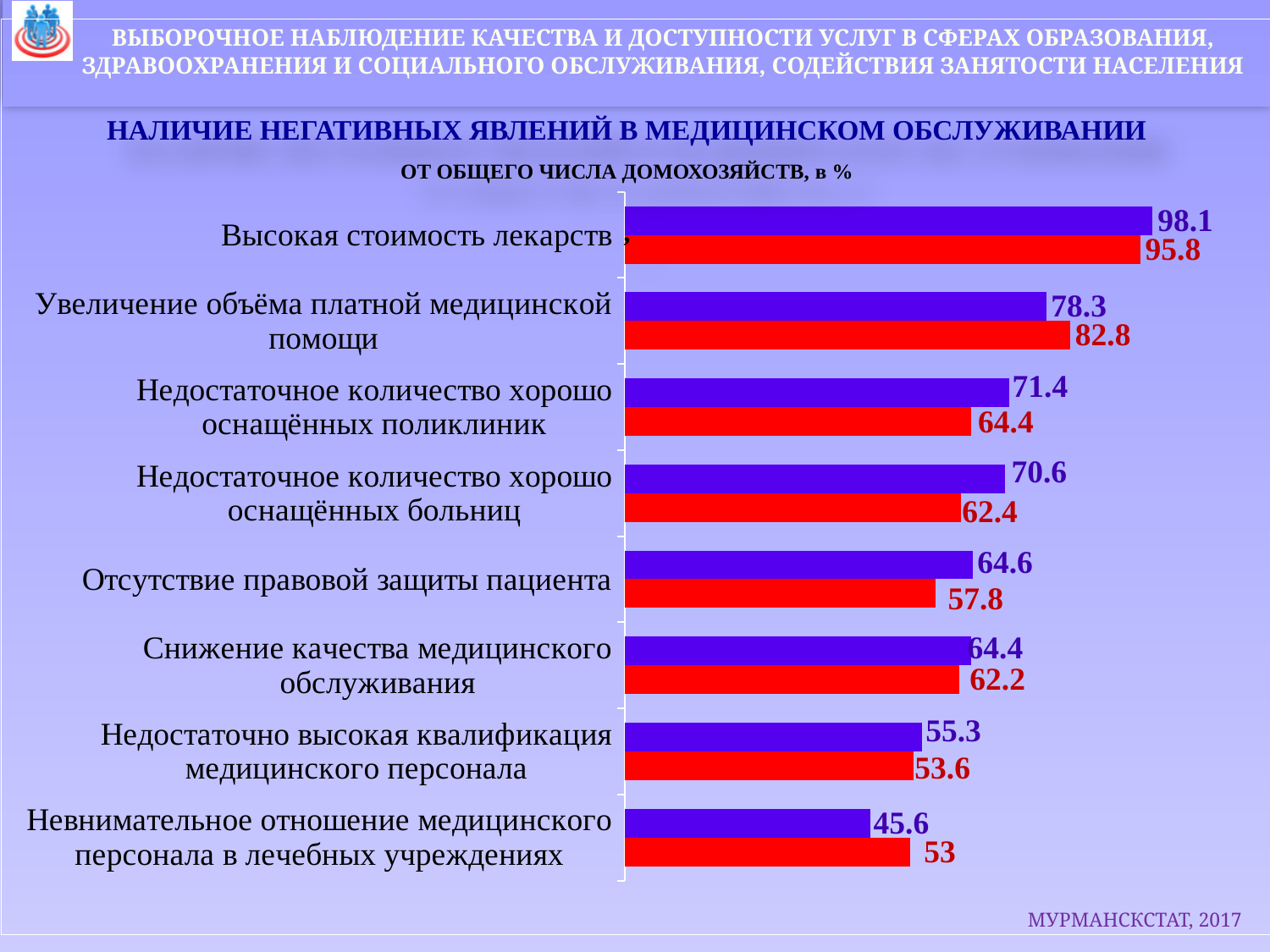
What is the difference between the purple and red bars for «Отсутствие правовой защиты пациента»? 6.8 What is the value of the red bar for «Невнимательное отношение медицинского персонала в лечебных учреждениях»? 53 How many categories (negative phenomena) are listed on the chart? 8 Which category has the highest value among the purple bars? Высокая стоимость лекарств What is the value of the red bar for «Увеличение объёма платной медицинской помощи»? 82.8 How many bars are shown for each category? 2 For «Увеличение объёма платной медицинской помощи», which bar is larger, the purple or the red one? Red Which category has the lowest value among the purple bars? Невнимательное отношение медицинского персонала в лечебных учреждениях What is the title of the chart? НАЛИЧИЕ НЕГАТИВНЫХ ЯВЛЕНИЙ В МЕДИЦИНСКОМ ОБСЛУЖИВАНИИ What is the value of the purple bar for «Высокая стоимость лекарств»? 98.1 What is the difference between the purple and red bars for «Недостаточное количество хорошо оснащённых больниц»? 8.2 What type of chart is shown on the slide? Bar chart